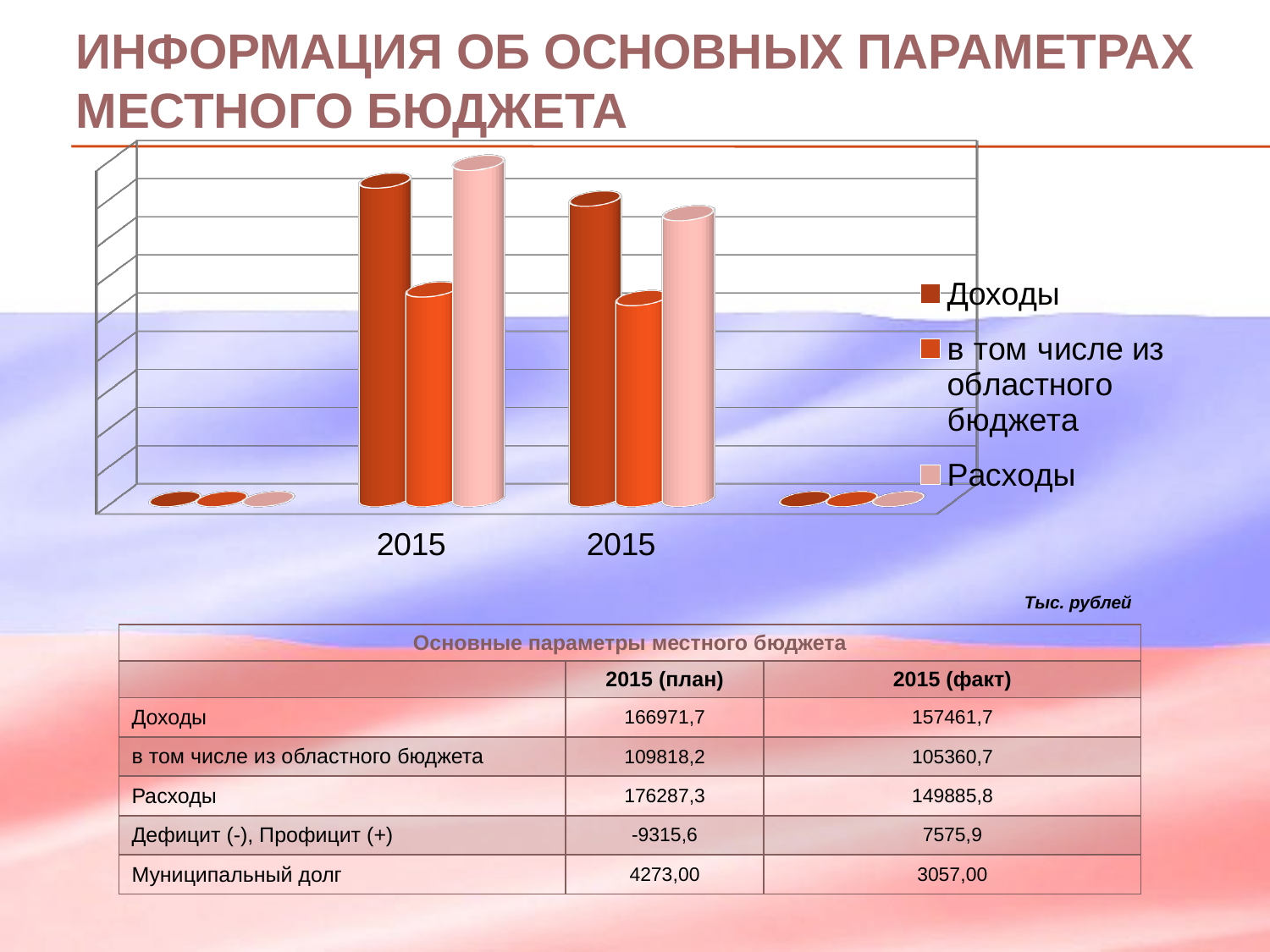
According to the table, what is the value of Расходы for 2015 (факт)? 149885,8 According to the table, what is the value of в том числе из областного бюджета for 2015 (план)? 109818,2 How many series does the chart legend list? 3 Does the Доходы bar rise or fall from the first group to the second group? fall What kind of chart is shown on the slide? bar chart According to the table, what is the value of Доходы for 2015 (план)? 166971,7 In the first (left) group of bars, which series has the lowest bar? в том числе из областного бюджета Which series is represented by the darkest red bars in the chart? Доходы In the first (left) group of bars, which series has the highest bar? Расходы Which series is represented by the light pink bars in the chart? Расходы In the second (right) group of bars, which series has the highest bar? Доходы How many groups of bars are plotted on the chart's x axis? 2